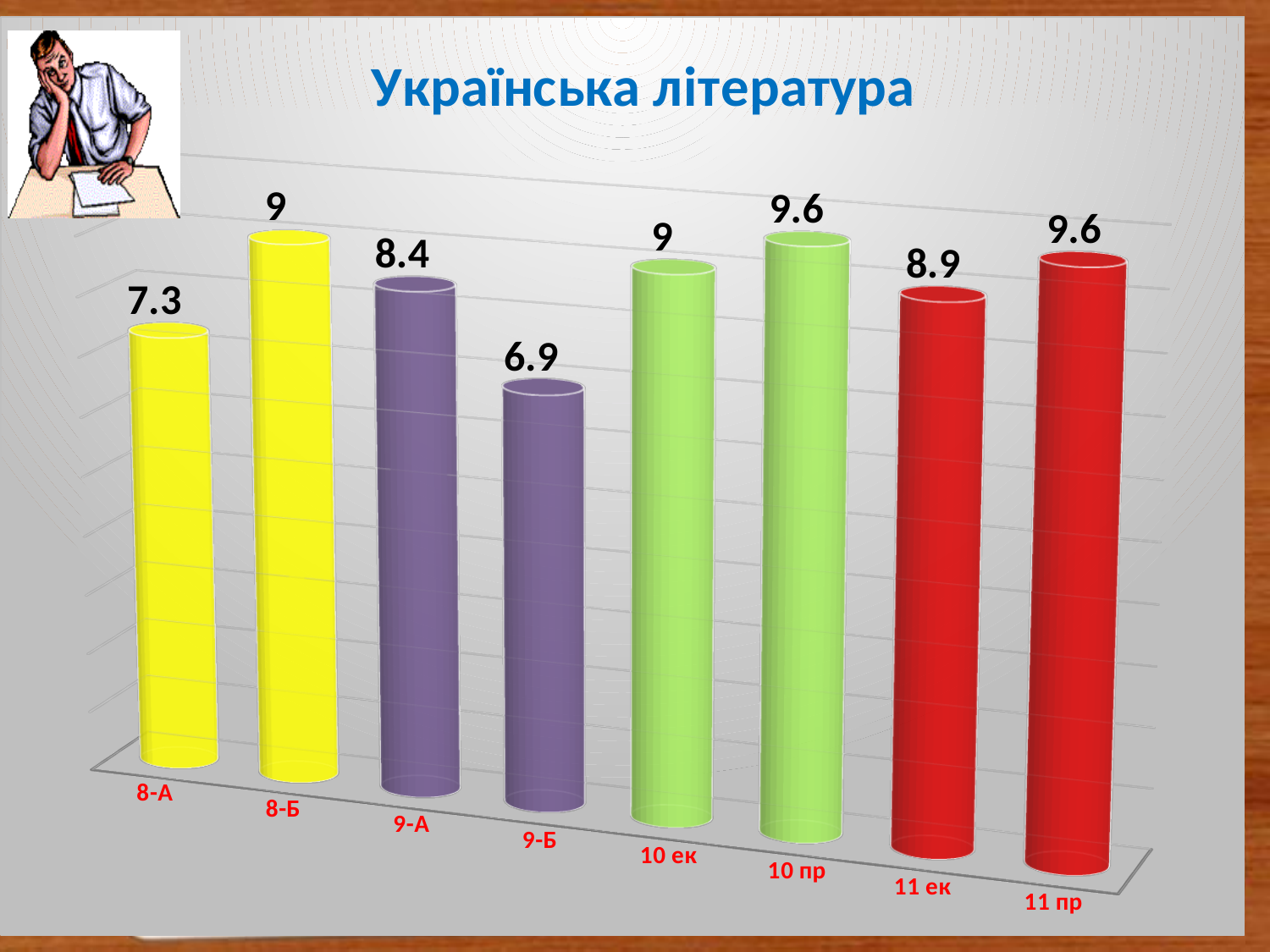
What is the title of the chart? Українська література How many categories are shown on the chart? 8 Which is larger, the value for 9-А or the value for 11 ек? 11 ек What is the value for 11 ек? 8.9 Which categories share the highest value? 10 пр and 11 пр Which category has the lowest value? 9-Б What is the difference between the values for 8-Б and 8-А? 1.7 What is the value for 10 пр? 9.6 What kind of chart is shown on the slide? Bar chart What is the difference between the values for 10 пр and 9-Б? 2.7 What is the value for 9-Б? 6.9 What is the value for 8-А? 7.3